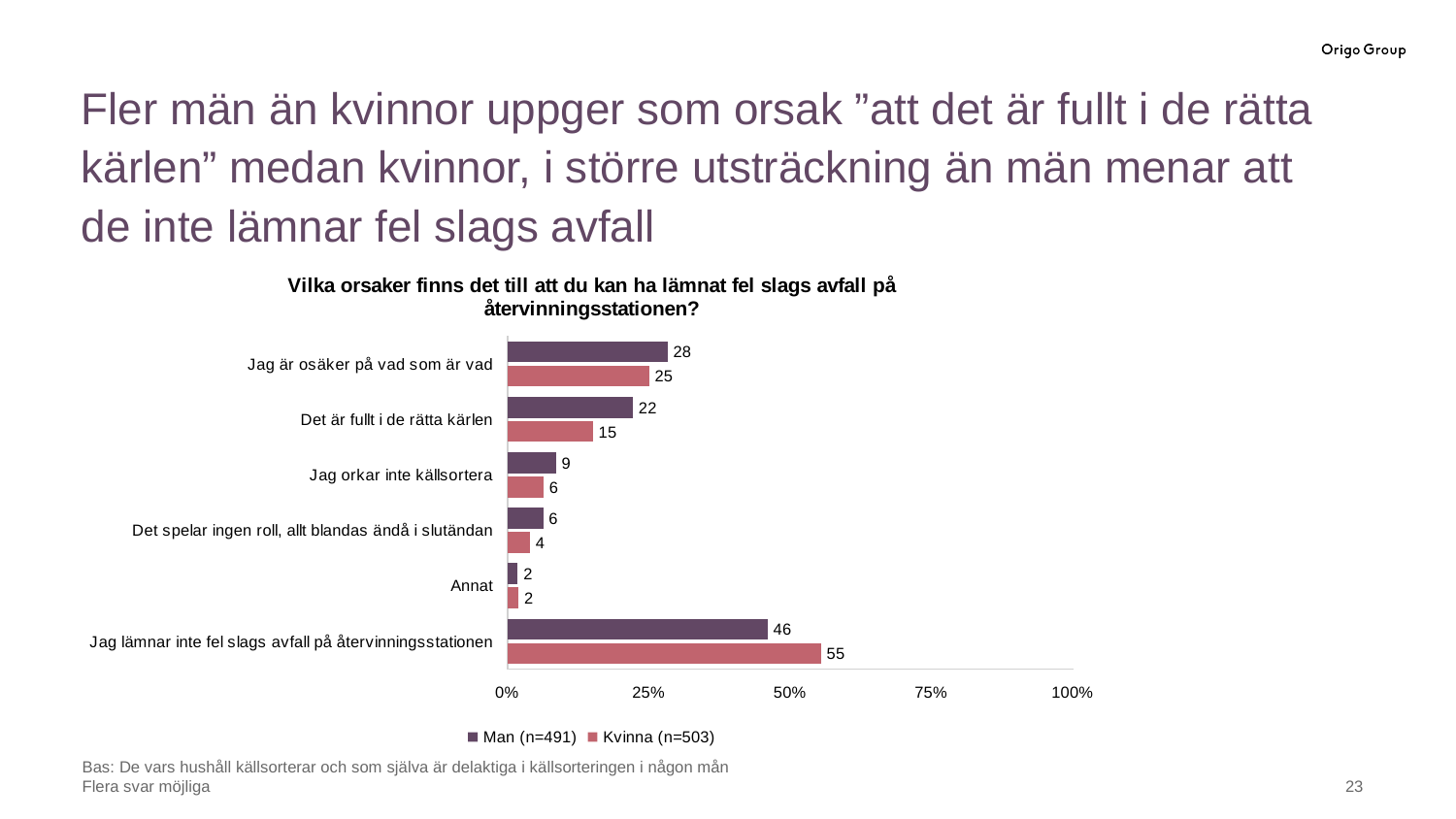
What is the difference between the Kvinna (n=503) and Man (n=491) values for "Jag lämnar inte fel slags avfall på återvinningsstationen"? 9 What is the value for Kvinna (n=503) for "Jag lämnar inte fel slags avfall på återvinningsstationen"? 55 What kind of chart is shown on the slide? bar chart How many categories are shown on the chart? 6 Which category has the highest value for Man (n=491)? Jag lämnar inte fel slags avfall på återvinningsstationen Is the value for Kvinna (n=503) for "Jag lämnar inte fel slags avfall på återvinningsstationen" greater or less than 50%? greater Which category has the lowest value for Kvinna (n=503)? Annat What is the difference between the Man (n=491) and Kvinna (n=503) values for "Det är fullt i de rätta kärlen"? 7 How many series does the legend list? 2 What is the value for Kvinna (n=503) for "Det är fullt i de rätta kärlen"? 15 Which is larger for "Jag orkar inte källsortera": the value for Man (n=491) or Kvinna (n=503)? Man (n=491) What is the value for Man (n=491) for "Jag är osäker på vad som är vad"? 28